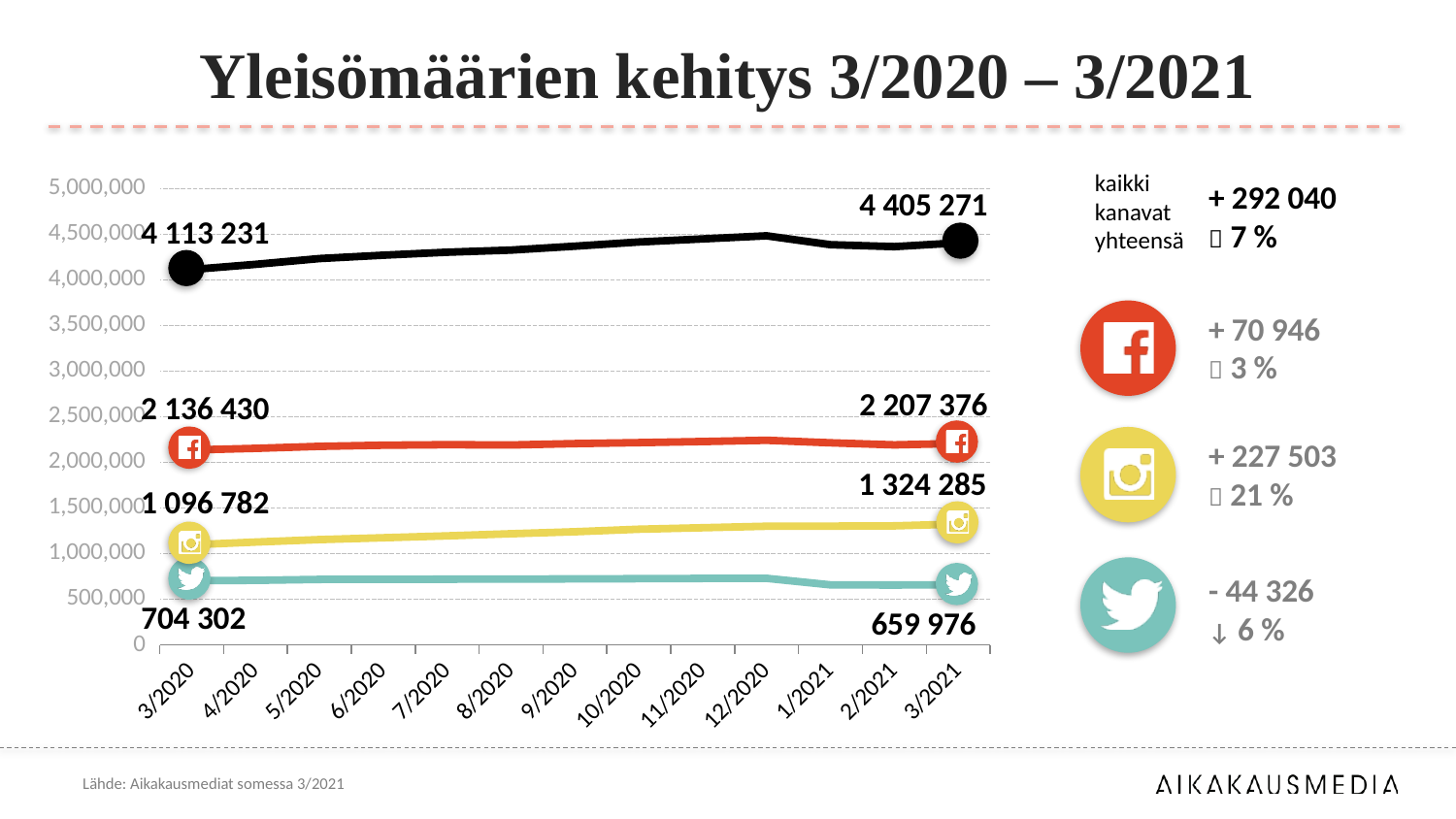
Does the Twitter (teal) line rise or fall from 3/2020 to 3/2021? fall Which series has the lowest value at 3/2021? Twitter (teal line) Is the value of the Facebook (red) line at 12/2020 greater or less than 2,000,000? greater What is the value of the Twitter (teal) line at 3/2021? 659 976 By how much did the Instagram (yellow) line change from 3/2020 to 3/2021? + 227 503 How many months are shown on the x axis? 13 By how much did the Twitter (teal) line change from 3/2020 to 3/2021? - 44 326 What is the value of the black (total) line at 3/2020? 4 113 231 What is the value of the Instagram (yellow) line at 3/2020? 1 096 782 What type of chart is shown on the slide? line chart What is the value of the Facebook (red) line at 3/2021? 2 207 376 What is the value of the black (total) line at 3/2021? 4 405 271